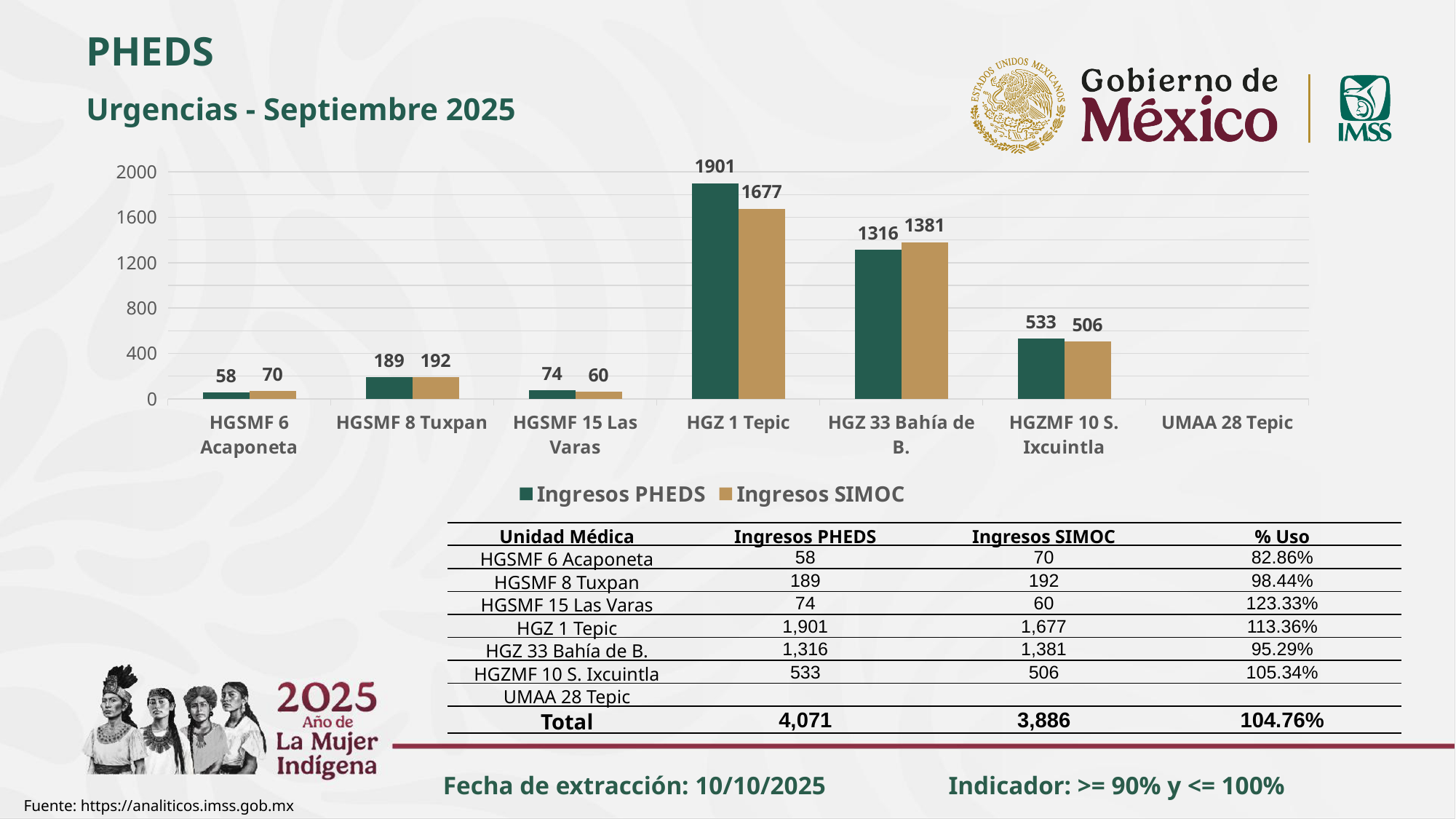
What is the Ingresos SIMOC value for HGZ 33 Bahía de B.? 1381 Which unit has the lowest Ingresos SIMOC value among those with bars shown? HGSMF 15 Las Varas What are the two series named in the chart legend? Ingresos PHEDS and Ingresos SIMOC What kind of chart is shown on the slide? Bar chart For HGZMF 10 S. Ixcuintla, which is larger: Ingresos PHEDS or Ingresos SIMOC? Ingresos PHEDS How many categories are shown on the x axis of the chart? 7 What is the Ingresos PHEDS value for HGSMF 6 Acaponeta? 58 Which unit has the highest Ingresos PHEDS value? HGZ 1 Tepic What is the difference between Ingresos PHEDS and Ingresos SIMOC for HGZ 1 Tepic? 224 How many series does the legend list? 2 Is the Ingresos SIMOC value for HGZ 1 Tepic greater or less than 1600? greater What is the Ingresos PHEDS value for HGZ 1 Tepic? 1901